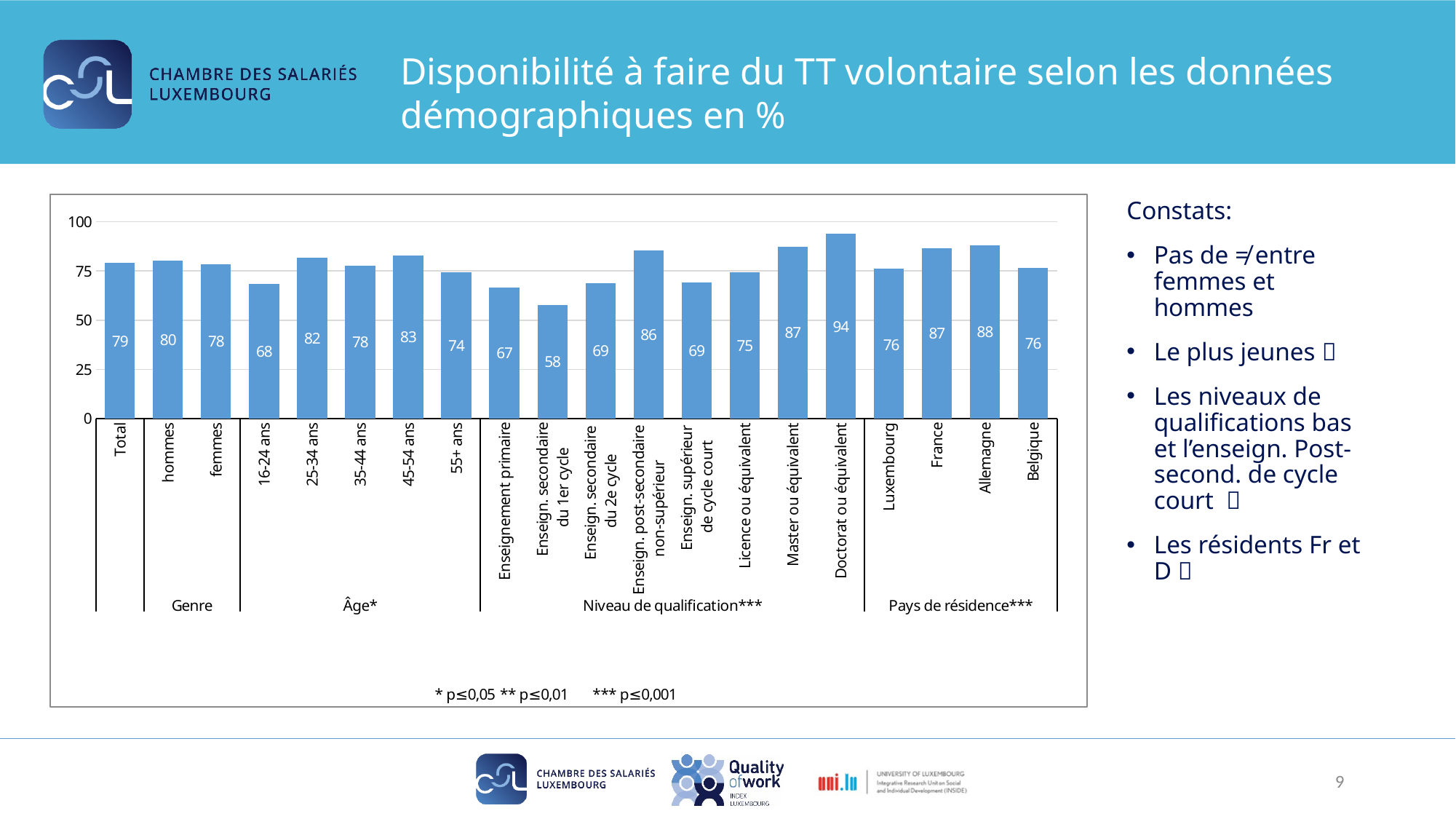
Which category has the lowest value? Enseign. secondaire du 1er cycle What is the value for 16-24 ans? 68 Which category has the highest value? Doctorat ou équivalent What is the difference between the values for hommes and femmes? 2 How many bars are plotted in the chart? 20 Is the value for Master ou équivalent greater or less than 75? greater What is the difference between the values for Doctorat ou équivalent and Enseign. secondaire du 1er cycle? 36 What is the value for Doctorat ou équivalent? 94 What kind of chart is shown on the slide? bar chart What is the value for Total? 79 Which is larger, the value for France or the value for Luxembourg? France What is the value for Allemagne? 88